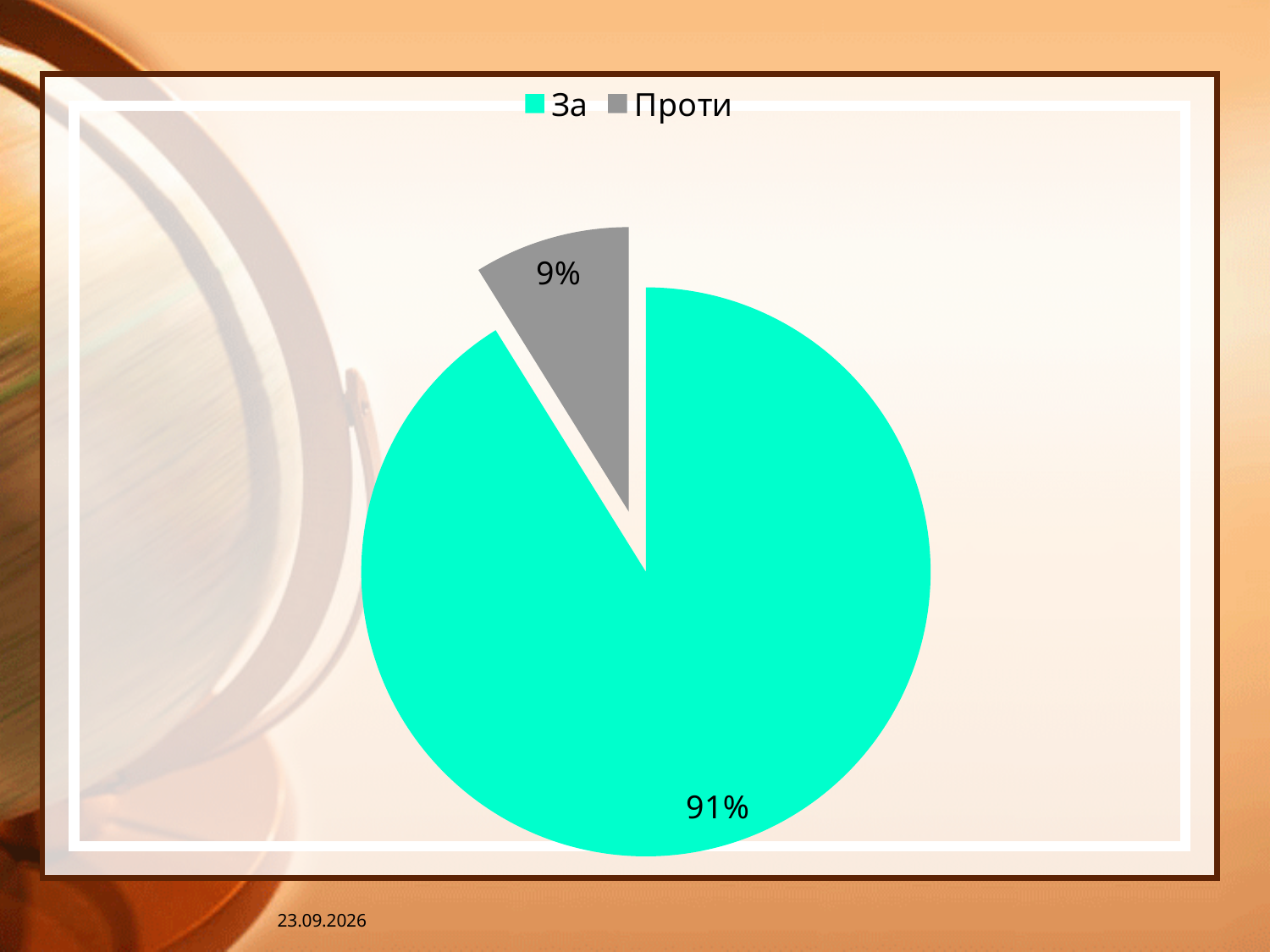
How many entries does the legend list? 2 What kind of chart is shown on the slide? pie chart How many slices does the pie chart have? 2 What is the difference in percentage points between the "За" and "Проти" slices? 82 What share of the pie does the "Проти" slice represent? 9% What share of the pie does the "За" slice represent? 91% Which is larger, the "За" slice or the "Проти" slice? За What colour is the "Проти" slice? grey What colour is the "За" slice? turquoise Which category has the largest slice of the pie? За Which category has the smallest slice of the pie? Проти